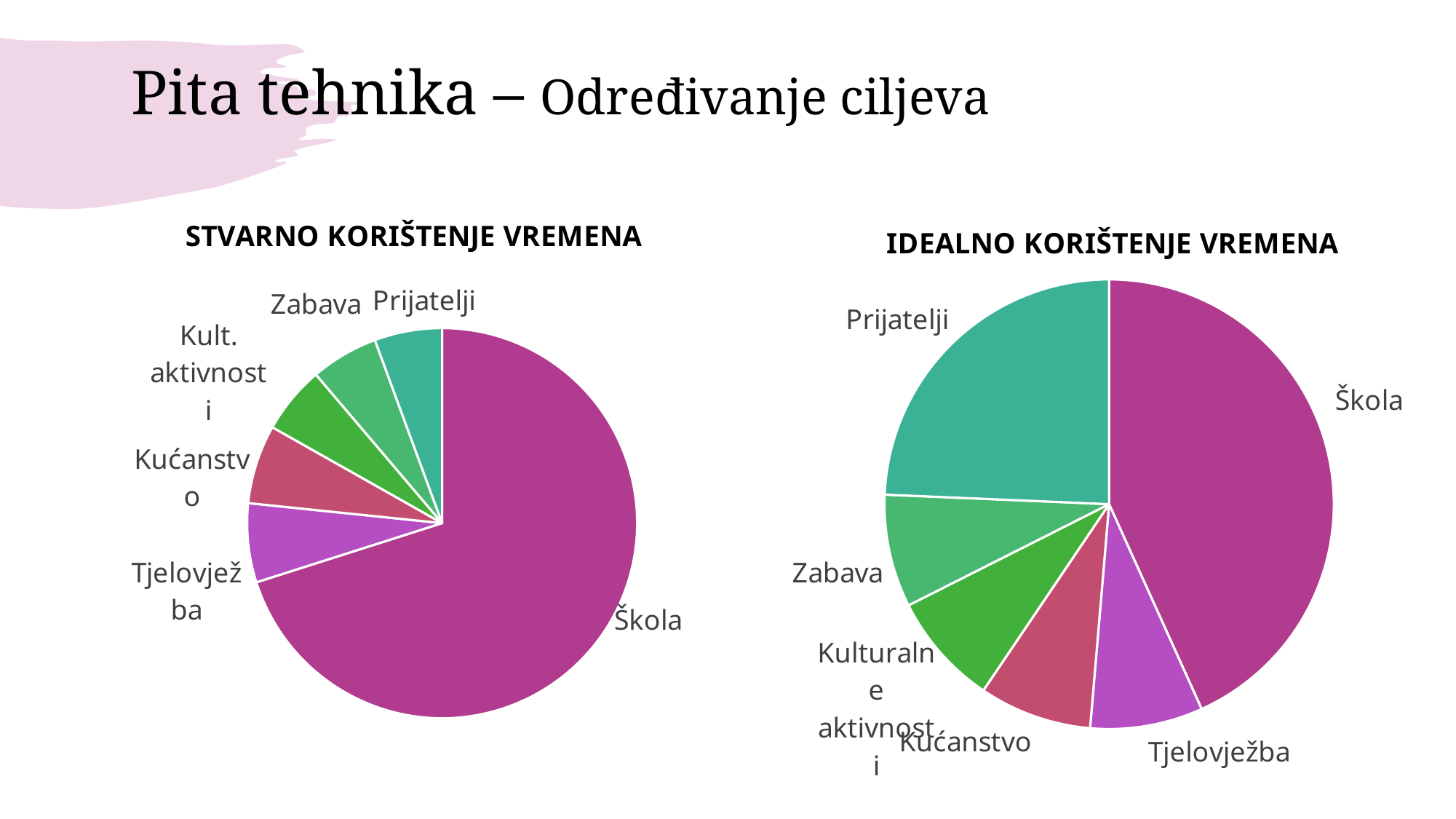
What kind of chart is the chart titled "IDEALNO KORIŠTENJE VREMENA"? pie chart In the chart titled "IDEALNO KORIŠTENJE VREMENA", which category has the largest slice? Škola What kind of chart is the chart titled "STVARNO KORIŠTENJE VREMENA"? pie chart In the chart titled "IDEALNO KORIŠTENJE VREMENA", which slice is larger, Škola or Prijatelji? Škola In the chart titled "STVARNO KORIŠTENJE VREMENA", which slice is larger, Tjelovježba or Prijatelji? Tjelovježba What is the title of the pie chart on the right side of the slide? IDEALNO KORIŠTENJE VREMENA In the chart titled "STVARNO KORIŠTENJE VREMENA", which slice is larger, Škola or Tjelovježba? Škola How many slices does the chart titled "STVARNO KORIŠTENJE VREMENA" have? 6 What is the title of the pie chart on the left side of the slide? STVARNO KORIŠTENJE VREMENA In the chart titled "STVARNO KORIŠTENJE VREMENA", which category has the largest slice? Škola How many slices does the chart titled "IDEALNO KORIŠTENJE VREMENA" have? 6